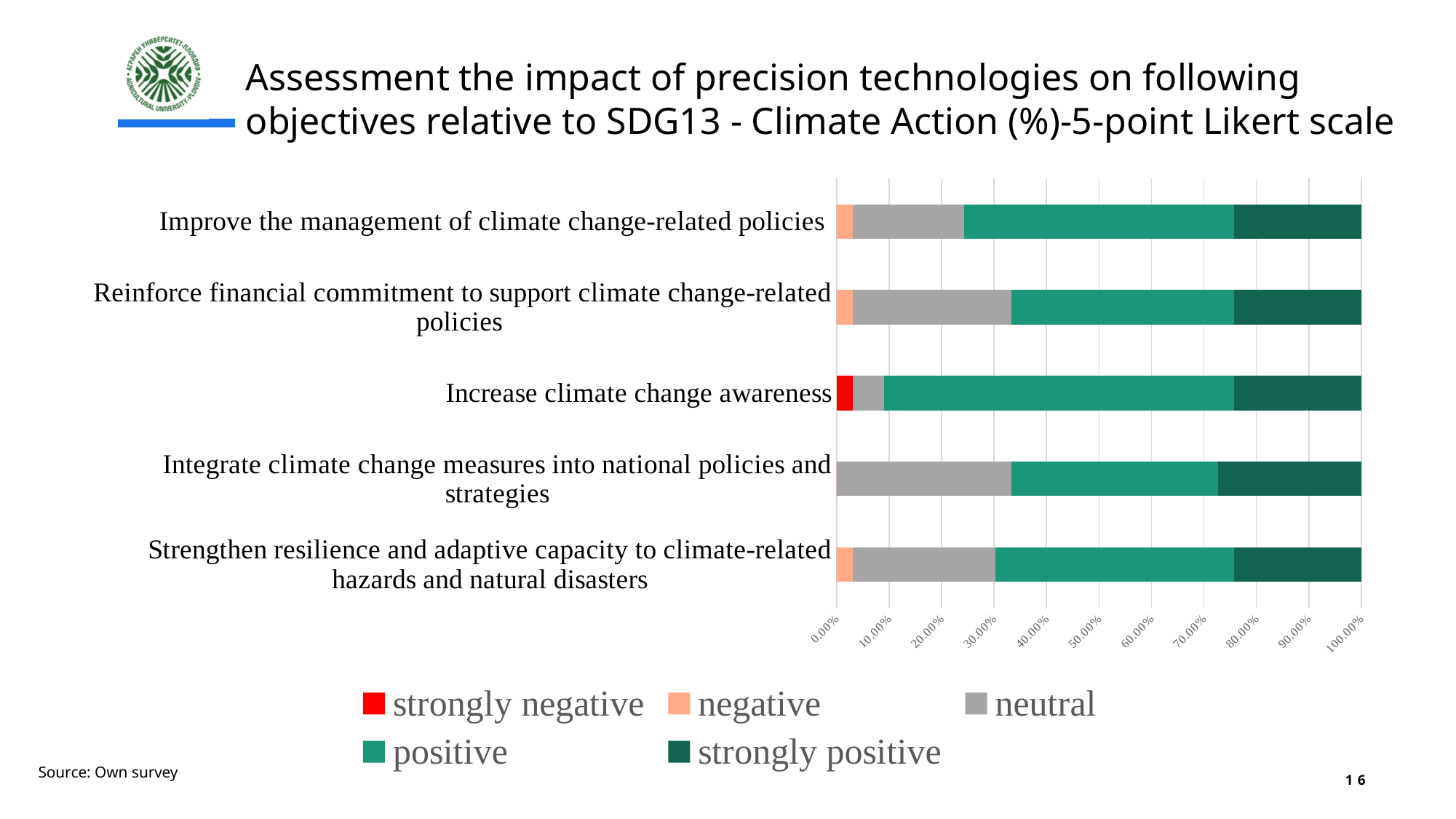
Is the 'positive' value for 'Increase climate change awareness' greater or less than 60.00%? greater What kind of chart is shown on the slide? stacked bar chart How many objectives (categories) are plotted in the chart? 5 Which objective is the only one with a 'strongly negative' segment? Increase climate change awareness For 'Improve the management of climate change-related policies', which is larger: the 'positive' segment or the 'neutral' segment? positive Is the 'neutral' value for 'Increase climate change awareness' greater or less than 10.00%? less Which series in the legend is shown in red? strongly negative What is the total of the stacked bar for 'Increase climate change awareness'? 100.00% Which objective has the largest 'positive' segment? Increase climate change awareness Is the 'neutral' value for 'Integrate climate change measures into national policies and strategies' greater or less than 20.00%? greater Which objective has the smallest 'neutral' segment? Increase climate change awareness How many series does the legend list? 5